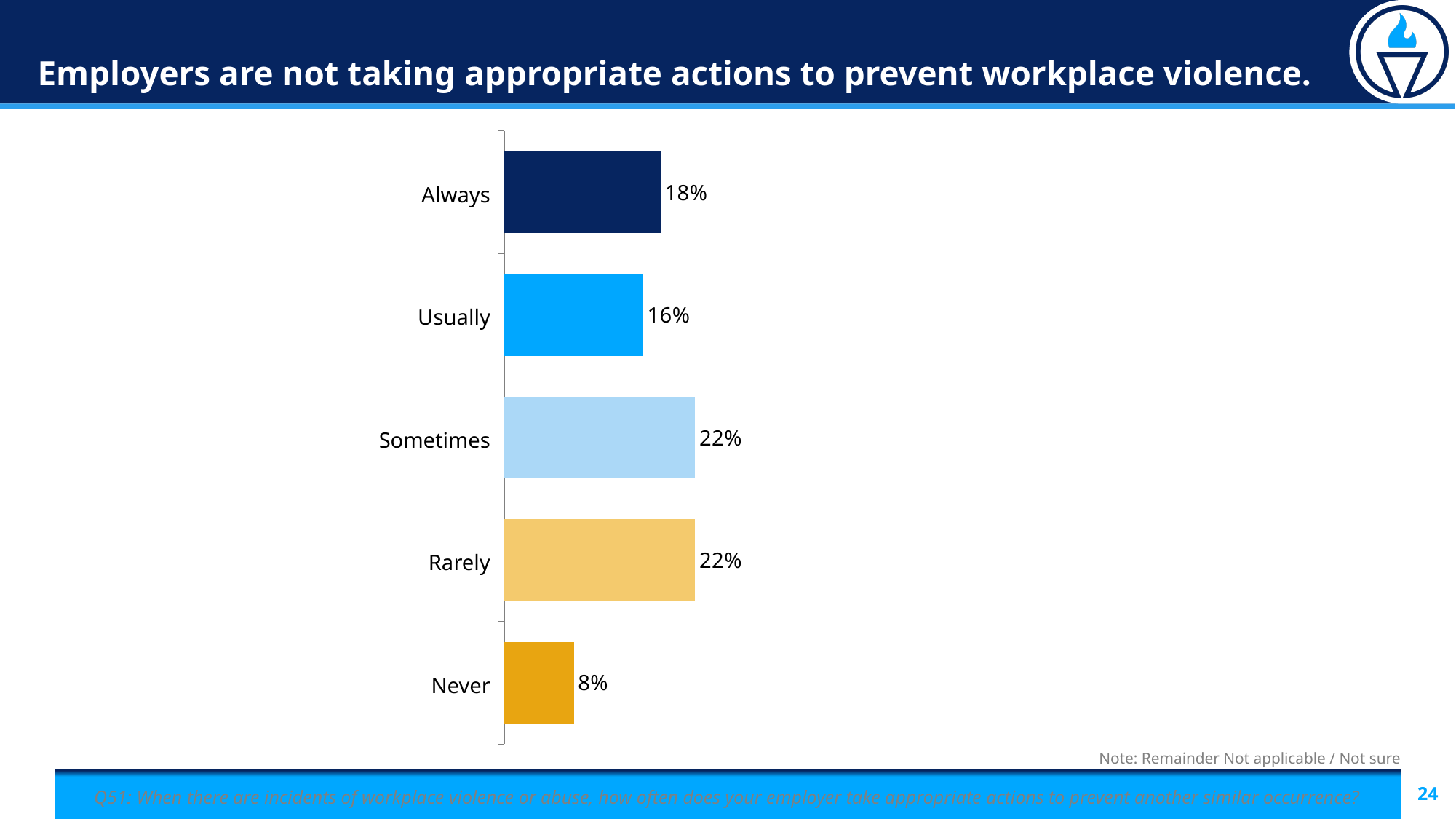
What is the value shown for 'Sometimes'? 22% What is the value shown for 'Usually'? 16% What is the combined value of 'Rarely' and 'Never'? 30% What is the value shown for 'Rarely'? 22% How many categories are shown in the chart? 5 What is the difference between the values for 'Rarely' and 'Never'? 14% What percentage of respondents said their employer 'Always' takes appropriate actions? 18% What percentage of respondents said their employer 'Never' takes appropriate actions? 8% What kind of chart is shown on the slide? Bar chart What is the difference between the values for 'Always' and 'Usually'? 2% Which category has the lowest value? Never Which is larger, the value for 'Sometimes' or the value for 'Always'? Sometimes